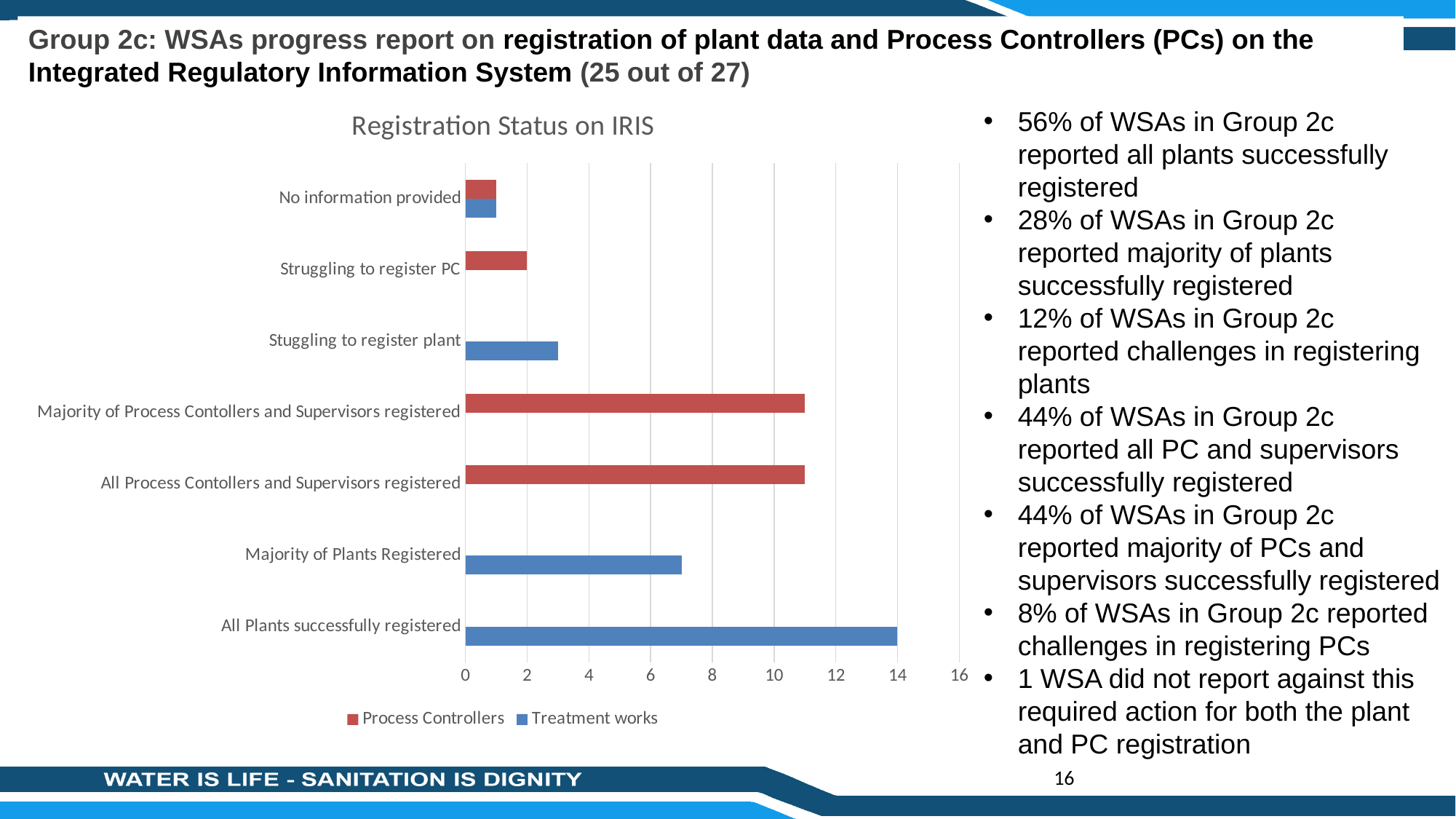
What is the title of the chart? Registration Status on IRIS How many categories are shown on the vertical axis of the chart? 7 What kind of chart is shown on the slide? bar chart Which category has the longest Treatment works bar? All Plants successfully registered What is the Treatment works value for 'All Plants successfully registered'? 14 How many series does the legend of the chart list? 2 Is the Process Controllers value for 'All Process Contollers and Supervisors registered' greater or less than 10? greater What is the Process Controllers value for 'Struggling to register PC'? 2 Is the Treatment works value for 'Majority of Plants Registered' greater or less than 6? greater Which has the larger Treatment works value: 'All Plants successfully registered' or 'Majority of Plants Registered'? All Plants successfully registered Is the Treatment works value for 'Stuggling to register plant' greater or less than 4? less What colour represents the Process Controllers series in the chart? red